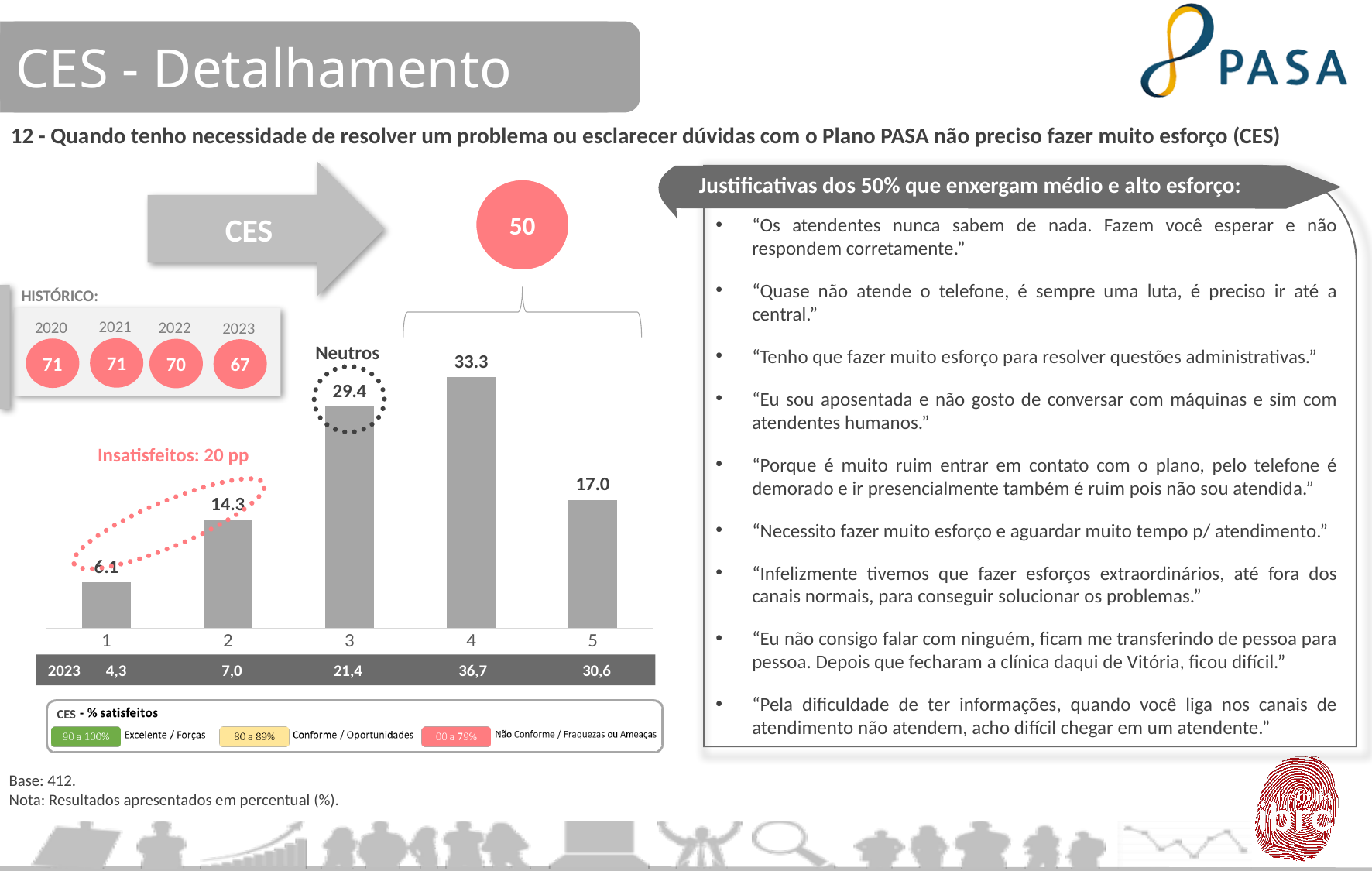
What type of chart is shown on the slide? bar chart Which category has the lowest bar? 1 What is the value of the bar for category 1? 6.1 How many categories are plotted on the x axis of the bar chart? 5 In the 'HISTÓRICO' box, what is the CES value shown for 2023? 67 What is the value of the bar for category 4? 33.3 Which is larger, the value for category 2 or the value for category 5? category 5 Which category has the highest bar? 4 What is the combined value of categories 1 and 2 (the 'Insatisfeitos' group)? 20.4 What is the difference between the values for category 4 and category 5? 16.3 In the 2023 row below the chart, what is the value shown for category 4? 36,7 What is the value of the bar labelled 'Neutros' (category 3)? 29.4